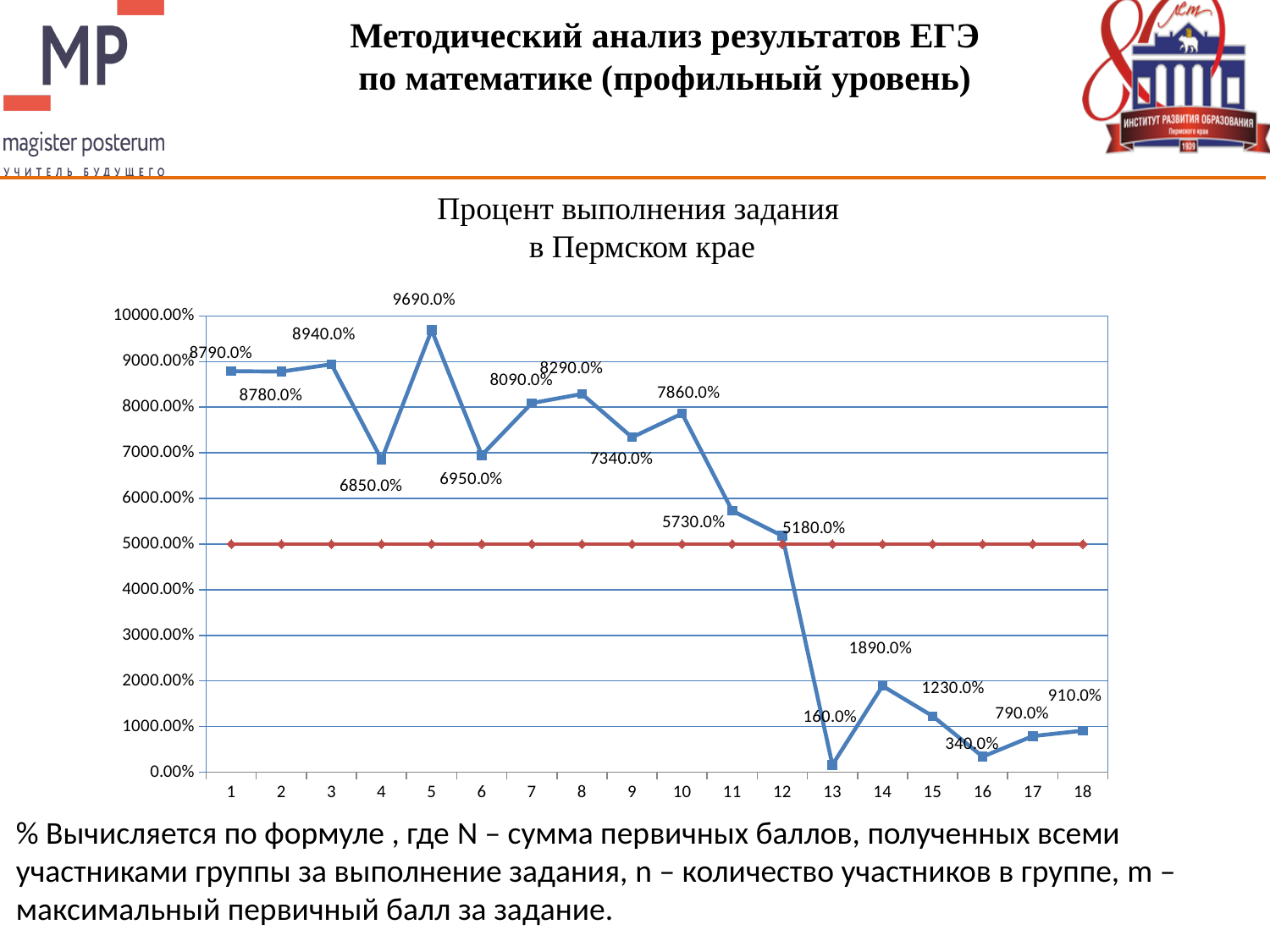
Do the values on the blue line generally rise or fall from task 12 to task 13? fall Which task has the highest value on the blue line? 5 What is the value for task 5? 9690.0% What is the title of the chart? Процент выполнения задания в Пермском крае What is the value for task 12? 5180.0% How many task numbers are shown along the x axis? 18 Which task has the lowest value on the blue line? 13 Is the value for task 11 greater or less than 5000.00%? greater What type of chart is shown on the slide? line chart What is the difference between the values for task 3 and task 4? 2090.0% What is the value for task 13? 160.0% Which is larger, the value for task 14 or the value for task 15? task 14